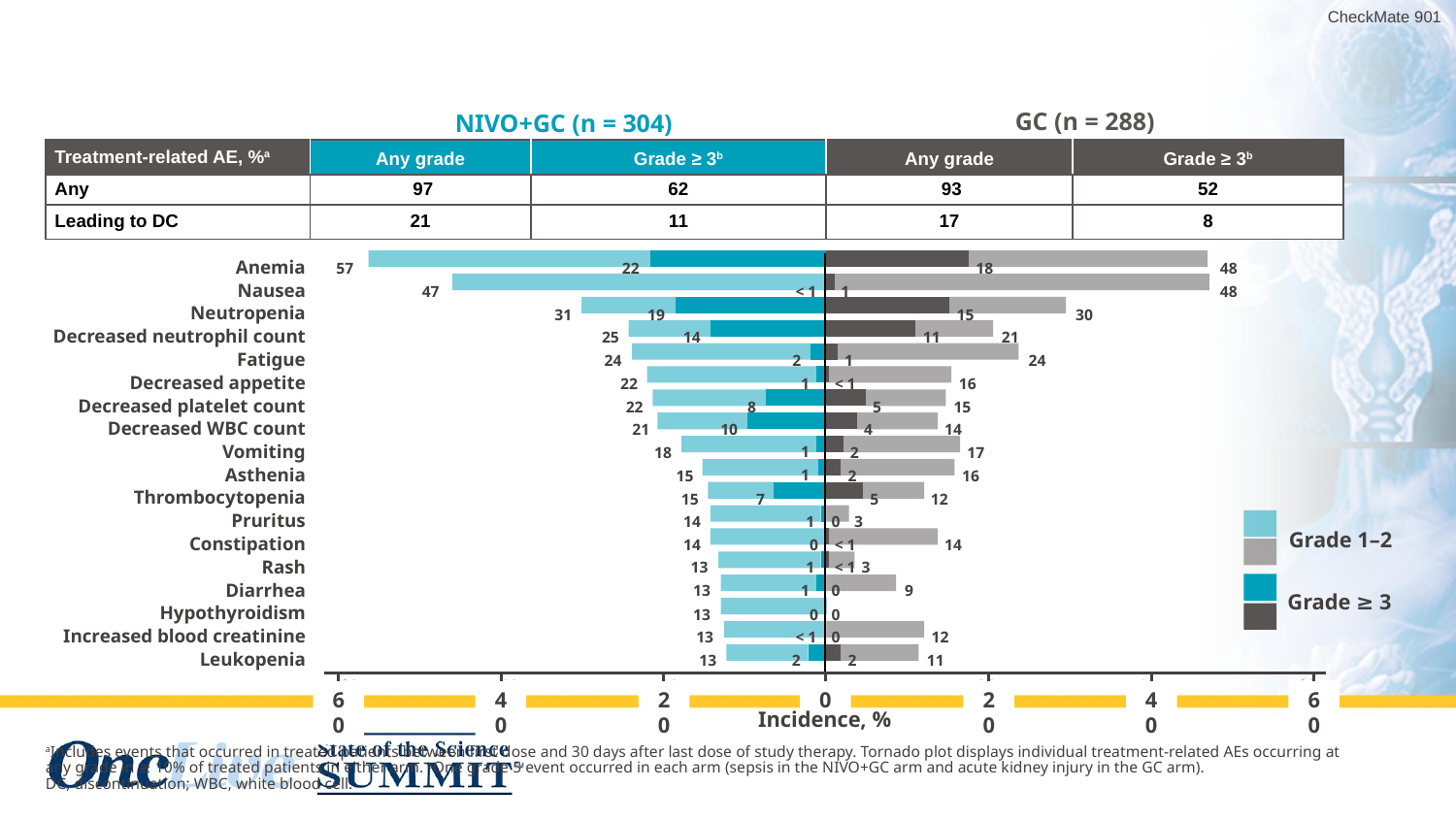
What is the any-grade incidence of anemia in the NIVO+GC arm? 57 What is the label on the x axis of the tornado plot? Incidence, % How many treatment-related adverse events are listed as categories in the tornado plot? 18 What is the grade ≥3 incidence of neutropenia in the NIVO+GC arm? 19 What is the difference between the any-grade incidence of anemia in the NIVO+GC arm and in the GC arm? 9 What is the any-grade incidence of nausea in the GC arm? 48 Which arm has the higher any-grade incidence of fatigue, NIVO+GC or GC? They are equal (24) Is the any-grade incidence of neutropenia in the NIVO+GC arm greater or less than 20? greater Which adverse event has the lowest any-grade incidence in the GC arm? Hypothyroidism Which adverse event has the highest any-grade incidence in the NIVO+GC arm? Anemia What is the grade ≥3 incidence of decreased neutrophil count in the GC arm? 11 What type of chart is shown on the slide? Bar chart (tornado plot)